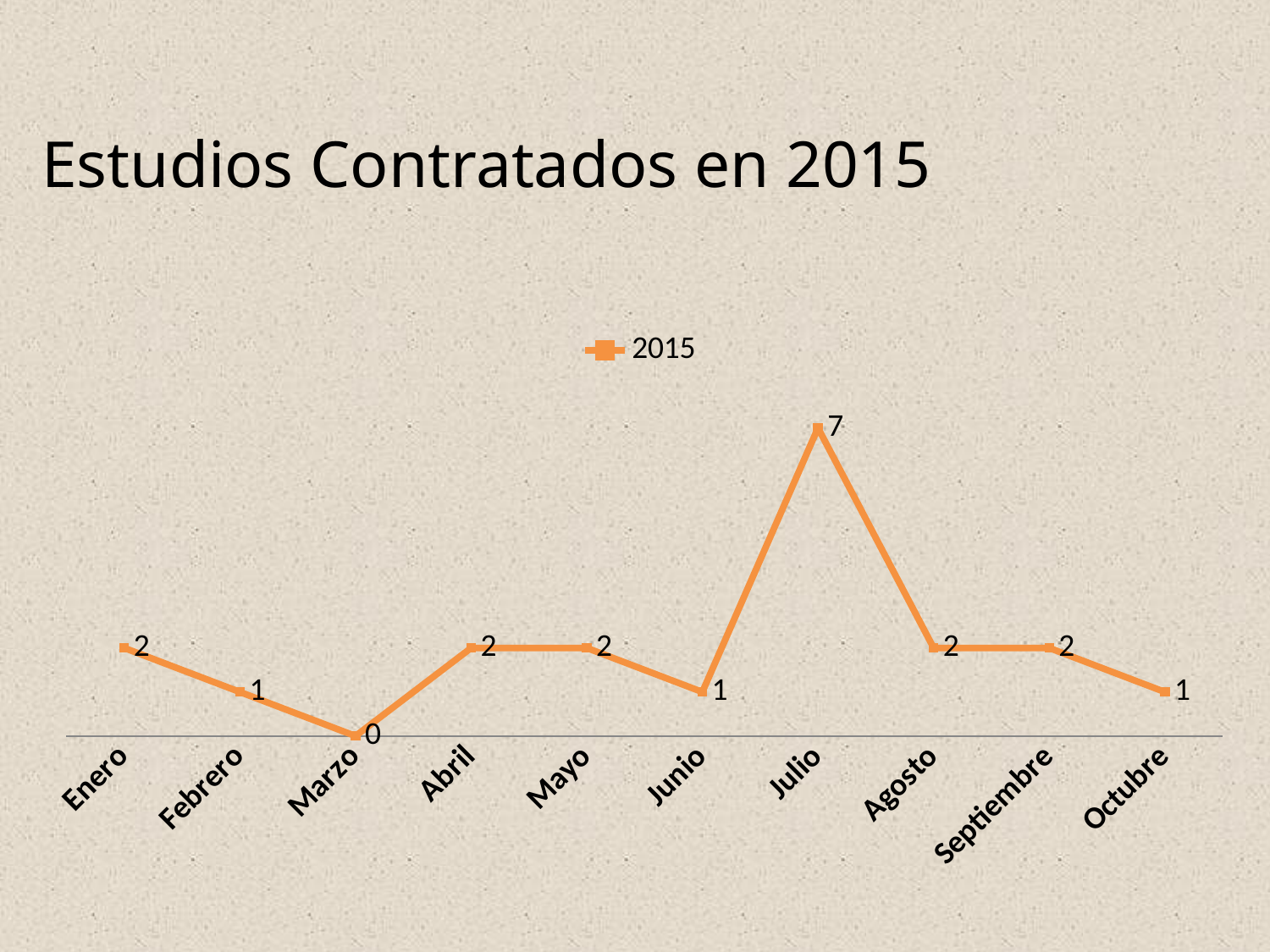
What is the value for Julio? 7 How many months are plotted on the x axis? 10 What is the value for Octubre? 1 How many series does the legend list? 1 What is the title of the slide? Estudios Contratados en 2015 Which is larger, the value for Febrero or the value for Abril? Abril What kind of chart is shown? Line chart What is the difference between the values for Julio and Agosto? 5 Which month has the lowest value? Marzo What is the value for Marzo? 0 Which month has the highest value? Julio What is the value for Enero? 2